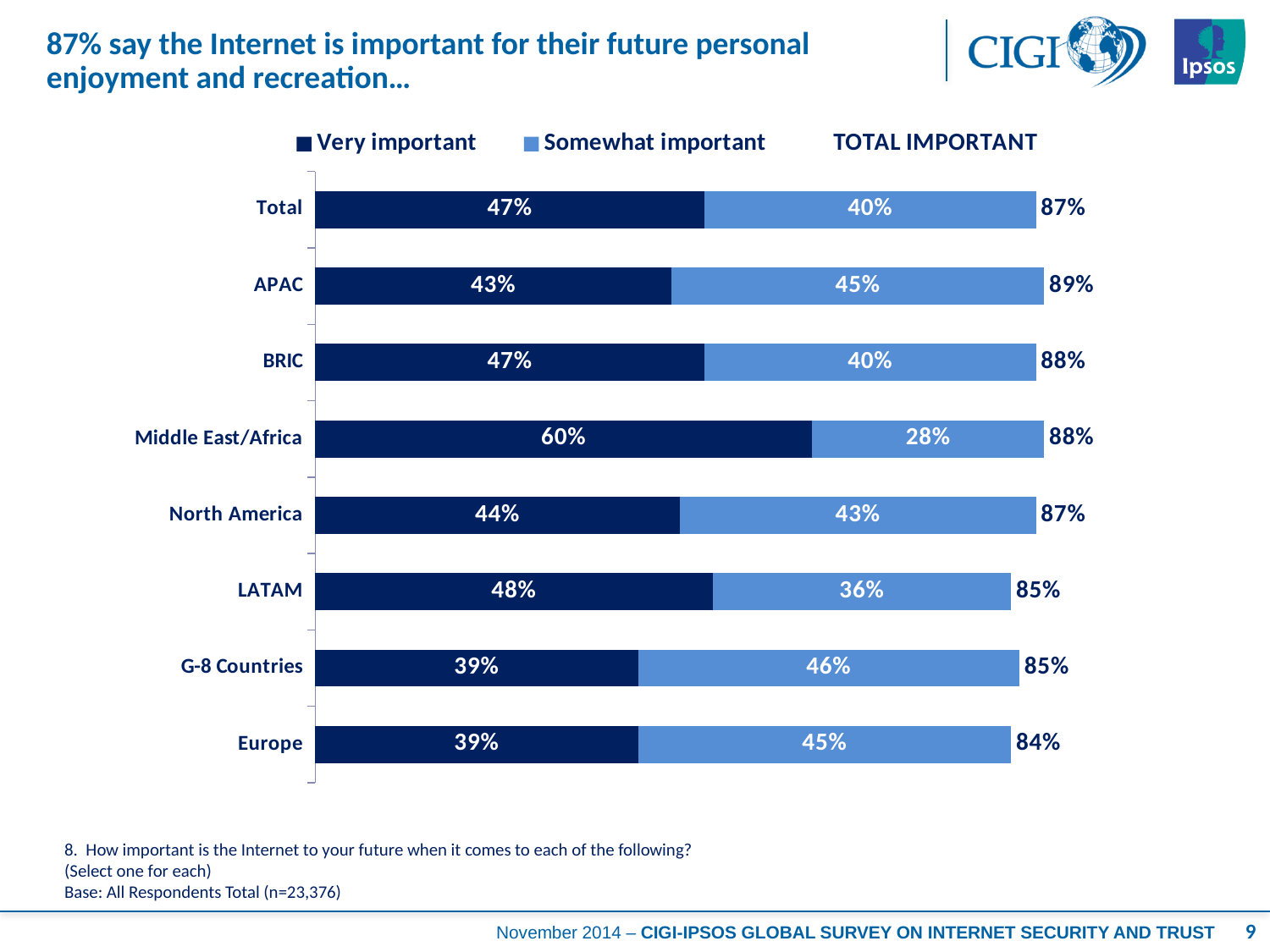
What percentage of respondents in Middle East/Africa say the Internet is "Very important" for their future personal enjoyment and recreation? 60% What is the TOTAL IMPORTANT value for APAC? 89% Which region has the highest "Very important" value? Middle East/Africa What is the combined total of "Very important" and "Somewhat important" for North America? 87% Which region has the lowest TOTAL IMPORTANT value? Europe What is the "Somewhat important" value for G-8 Countries? 46% Which series is shown in the darker blue colour? Very important Which is larger, the "Somewhat important" value for APAC or for LATAM? APAC What is the difference between the "Very important" values for Middle East/Africa and Europe? 21 percentage points How many categories (regions, including Total) are shown on the chart? 8 What kind of chart is shown on the slide? Stacked bar chart